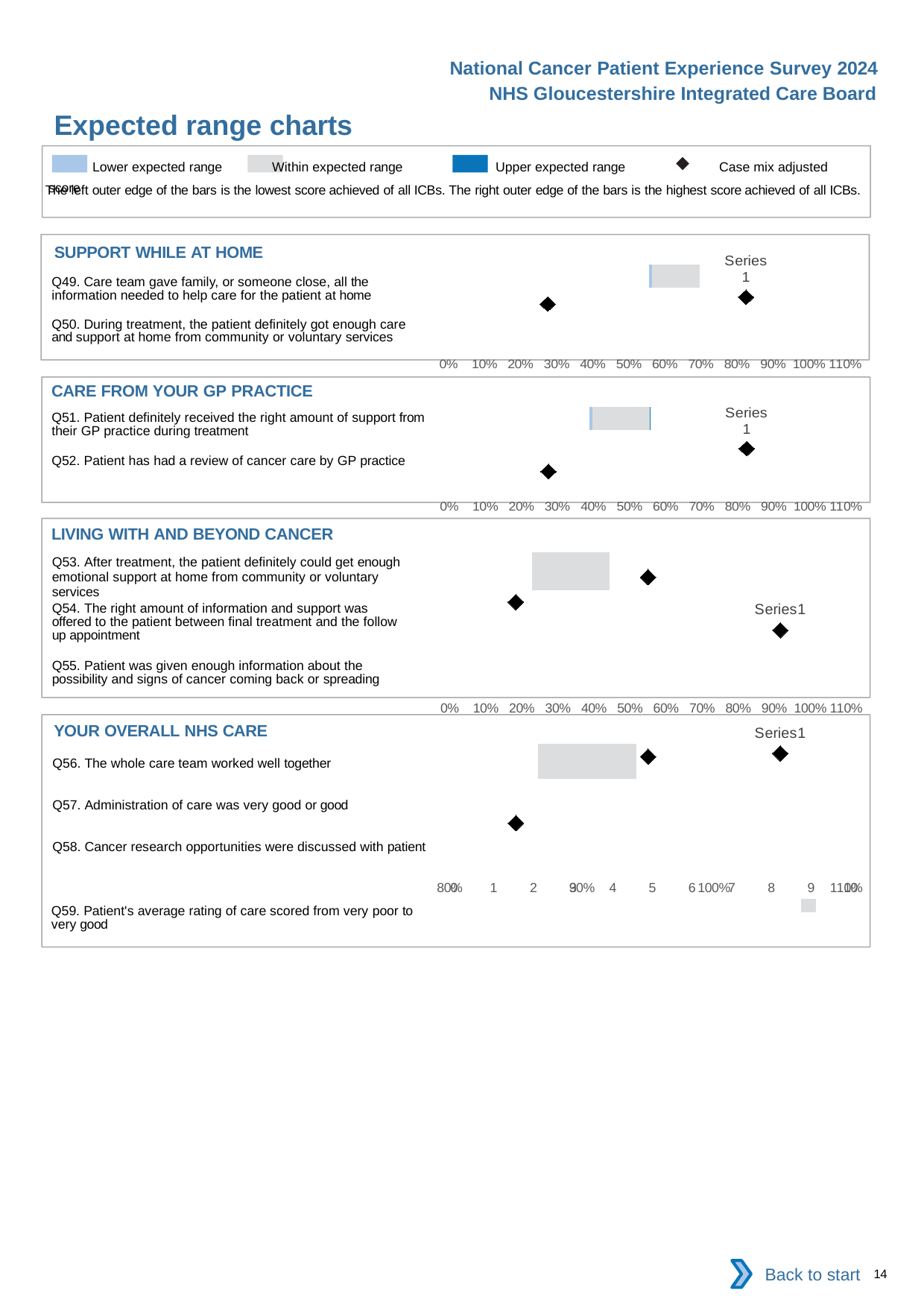
How many questions are listed in the YOUR OVERALL NHS CARE chart? 4 According to the legend, what does the black diamond marker represent? Case mix adjusted score In the SUPPORT WHILE AT HOME chart, is the right edge of the grey expected range bar greater or less than 50%? greater What kind of chart is used in the Expected range charts on this slide? bar chart How many questions are listed in the SUPPORT WHILE AT HOME chart? 2 What is the title of the slide containing these charts? Expected range charts How many entries does the legend at the top of the slide list? 4 How many questions are listed in the LIVING WITH AND BEYOND CANCER chart? 3 In the CARE FROM YOUR GP PRACTICE chart, is the lowest-positioned diamond marker greater or less than 50%? less